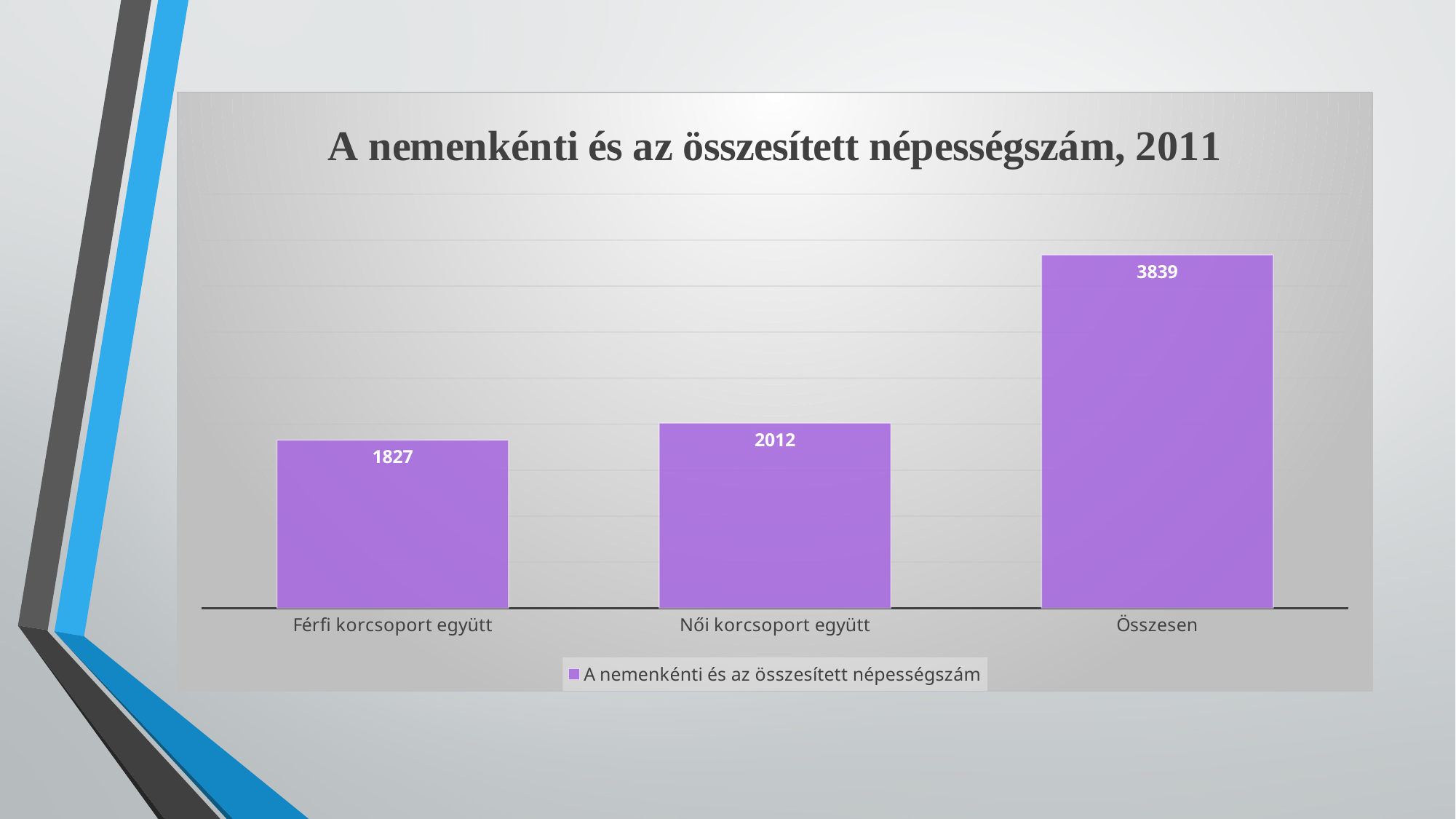
What is the value for Összesen? 3839 What kind of chart is shown on the slide? bar chart Which category has the lowest value? Férfi korcsoport együtt How many categories are shown on the x axis? 3 Which category has the highest value? Összesen What is the title of the chart? A nemenkénti és az összesített népességszám, 2011 What is the value for Női korcsoport együtt? 2012 How many series does the legend list? 1 What is the difference between the values for Összesen and Női korcsoport együtt? 1827 Which is larger, the value for Férfi korcsoport együtt or the value for Női korcsoport együtt? Női korcsoport együtt What is the difference between the values for Női korcsoport együtt and Férfi korcsoport együtt? 185 What is the value for Férfi korcsoport együtt? 1827